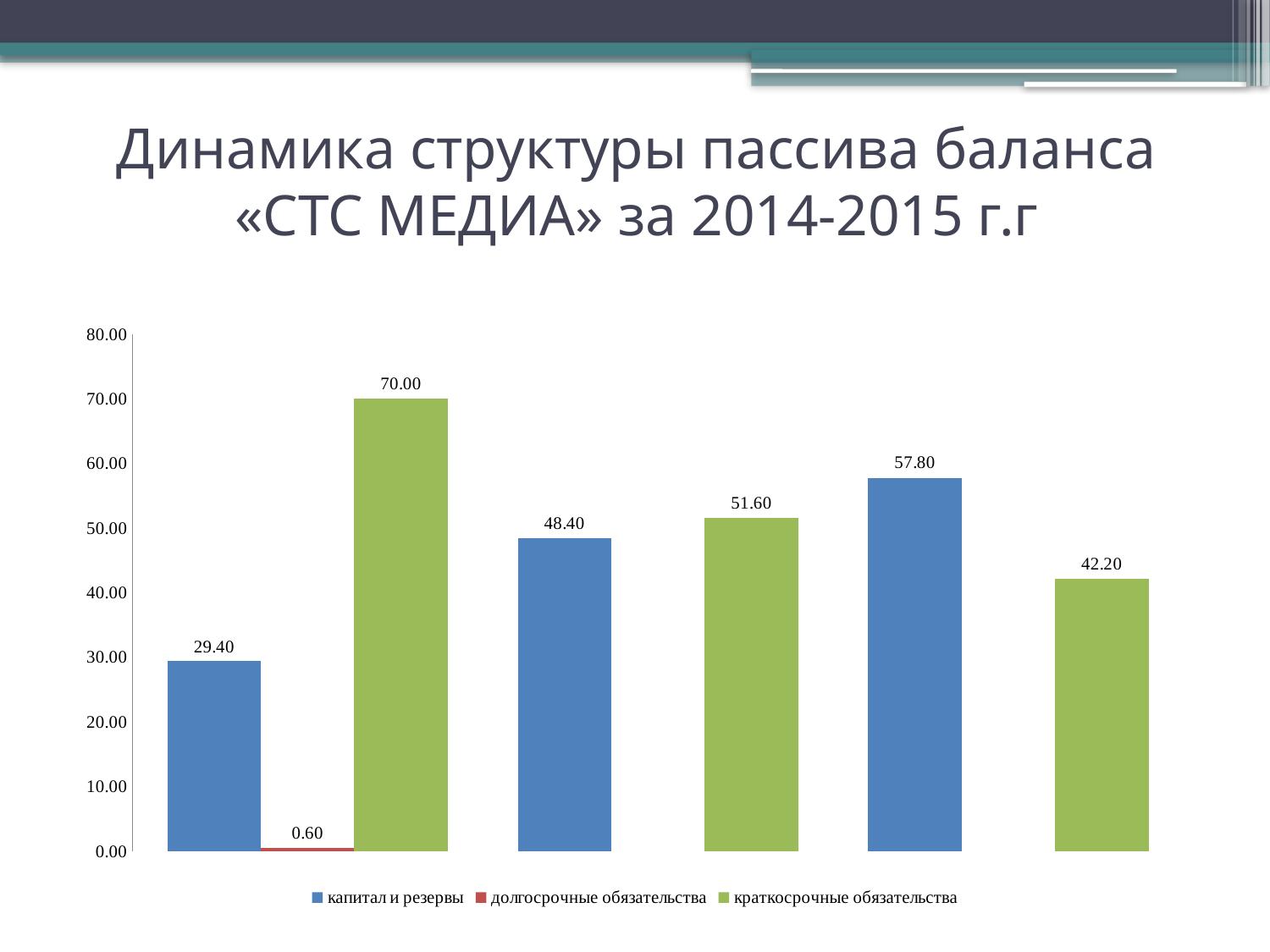
Which bar has the highest value on the chart? краткосрочные обязательства in the leftmost group (70.00) How many groups of bars are plotted along the x axis? 3 What is the value of краткосрочные обязательства in the rightmost group of bars? 42.20 In the rightmost group, which is larger: капитал и резервы or краткосрочные обязательства? капитал и резервы How many series does the legend list? 3 What is the lowest value labelled on the chart? 0.60 In the leftmost group, what is the difference between краткосрочные обязательства and капитал и резервы? 40.60 What is the value of капитал и резервы in the leftmost group of bars? 29.40 Do the values for капитал и резервы rise or fall from left to right across the groups? rise What is the value of долгосрочные обязательства in the leftmost group of bars? 0.60 What colour are the bars for краткосрочные обязательства? green What kind of chart is shown on the slide? bar chart